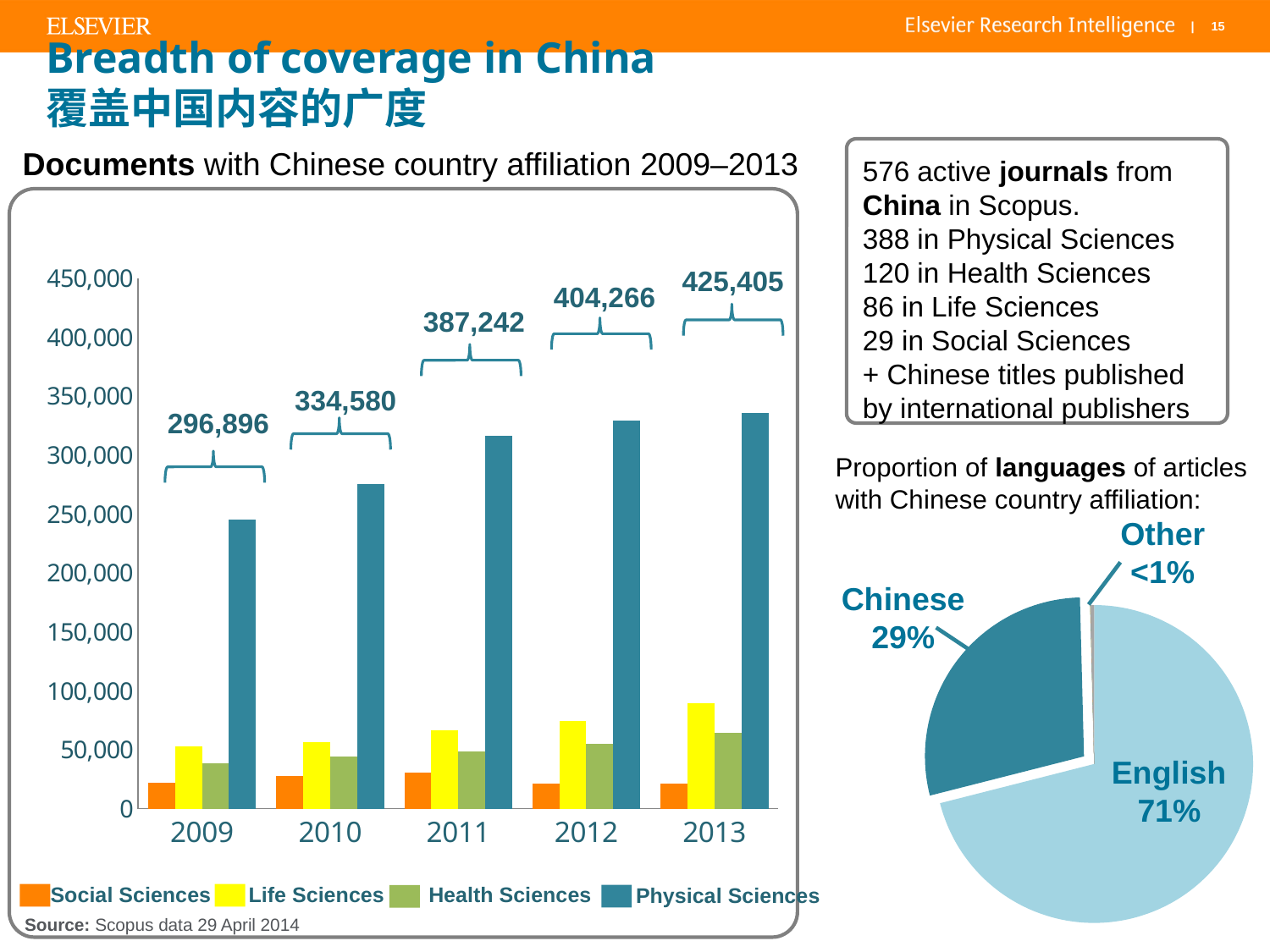
On the bar chart of documents with Chinese country affiliation, what is the difference between the 2013 total and the 2012 total? 21,139 On the bar chart of documents with Chinese country affiliation, is the value for Physical Sciences in 2013 greater or less than 300,000? greater What kind of chart is the documents with Chinese country affiliation chart? bar chart On the pie chart of languages of articles with Chinese country affiliation, what share is English? 71% On the bar chart of documents with Chinese country affiliation, do the yearly totals rise or fall from 2009 to 2013? rise On the bar chart of documents with Chinese country affiliation, what is the total number of documents shown for 2011? 387,242 On the bar chart of documents with Chinese country affiliation, which year has the lowest total? 2009 On the bar chart of documents with Chinese country affiliation, which year has the highest total? 2013 On the bar chart of documents with Chinese country affiliation, how many years are shown on the x axis? 5 On the pie chart of languages of articles with Chinese country affiliation, which language has the largest share? English On the bar chart of documents with Chinese country affiliation, what is the total number of documents shown for 2009? 296,896 On the bar chart of documents with Chinese country affiliation, how many series does the legend list? 4